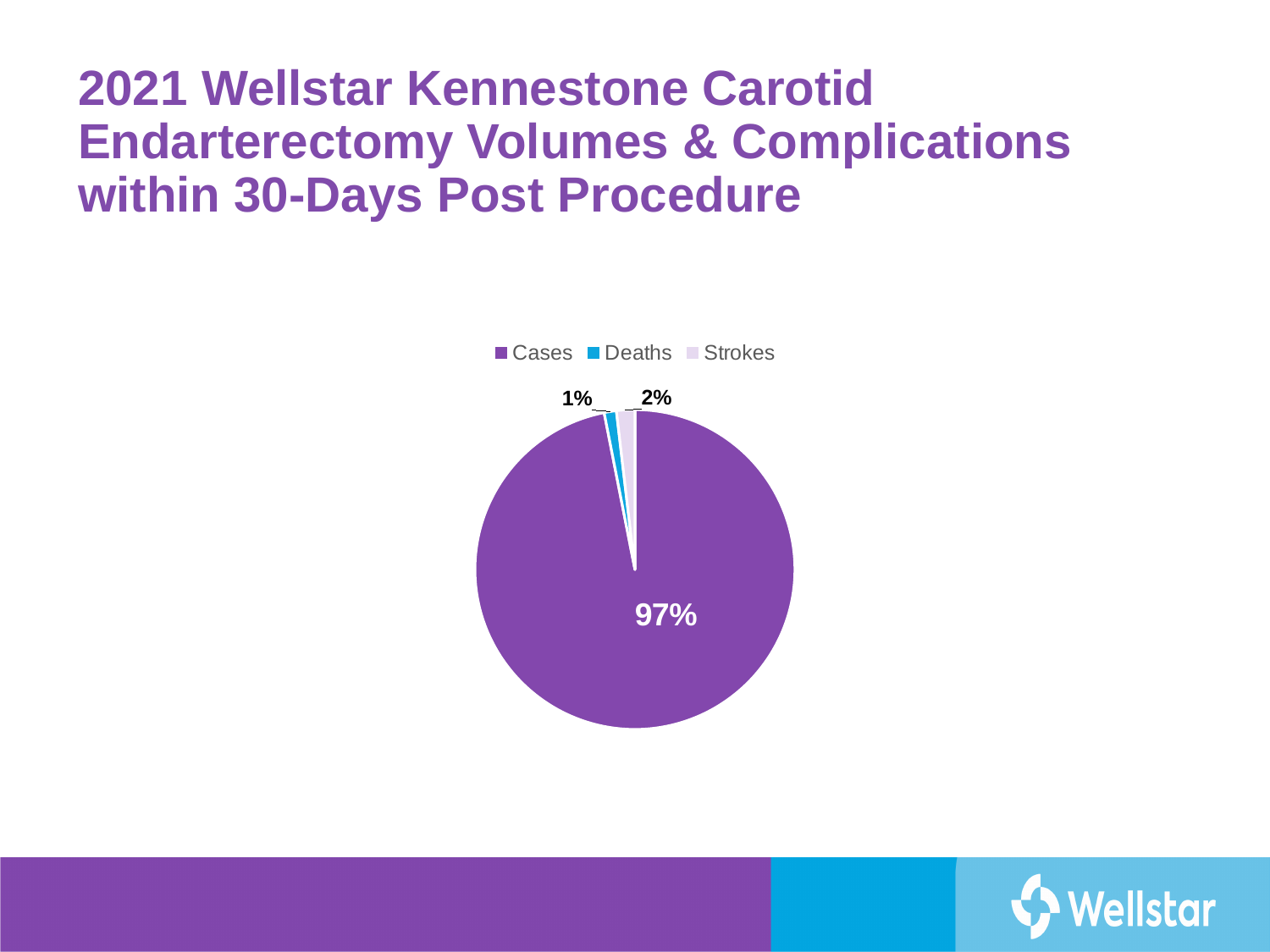
What colour is the Deaths slice? blue Which category has the largest slice of the pie? Cases What is the difference in percentage points between the Cases slice and the Strokes slice? 95 What percentage share does the Cases slice have? 97% What kind of chart is shown on the slide? pie chart How many slices does the pie chart have? 3 Where is the legend positioned relative to the pie? above the pie What percentage share does the Deaths slice have? 1% Which category has the smallest slice of the pie? Deaths How many entries does the legend list? 3 Which is larger, the Strokes slice or the Deaths slice? Strokes What percentage share does the Strokes slice have? 2%